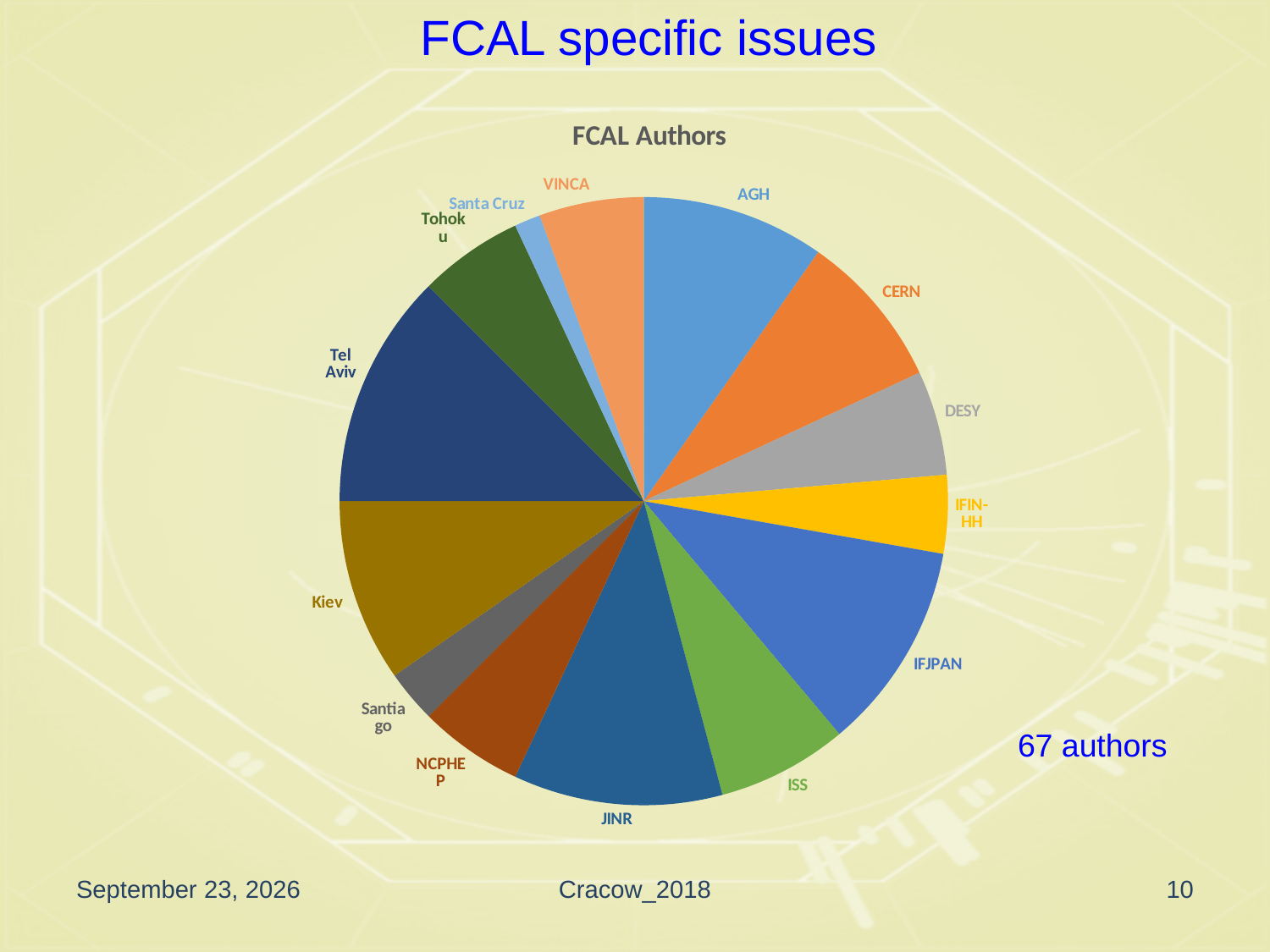
How many slices does the pie chart have? 14 Which slice is larger, Kiev or Santiago? Kiev Which slice is larger, Tel Aviv or Santa Cruz? Tel Aviv What colour is the IFIN-HH slice? yellow Which slice is larger, IFJPAN or DESY? IFJPAN What is the title of the chart? FCAL Authors What kind of chart is shown on the slide? pie chart Which slice of the pie chart is the smallest? Santa Cruz